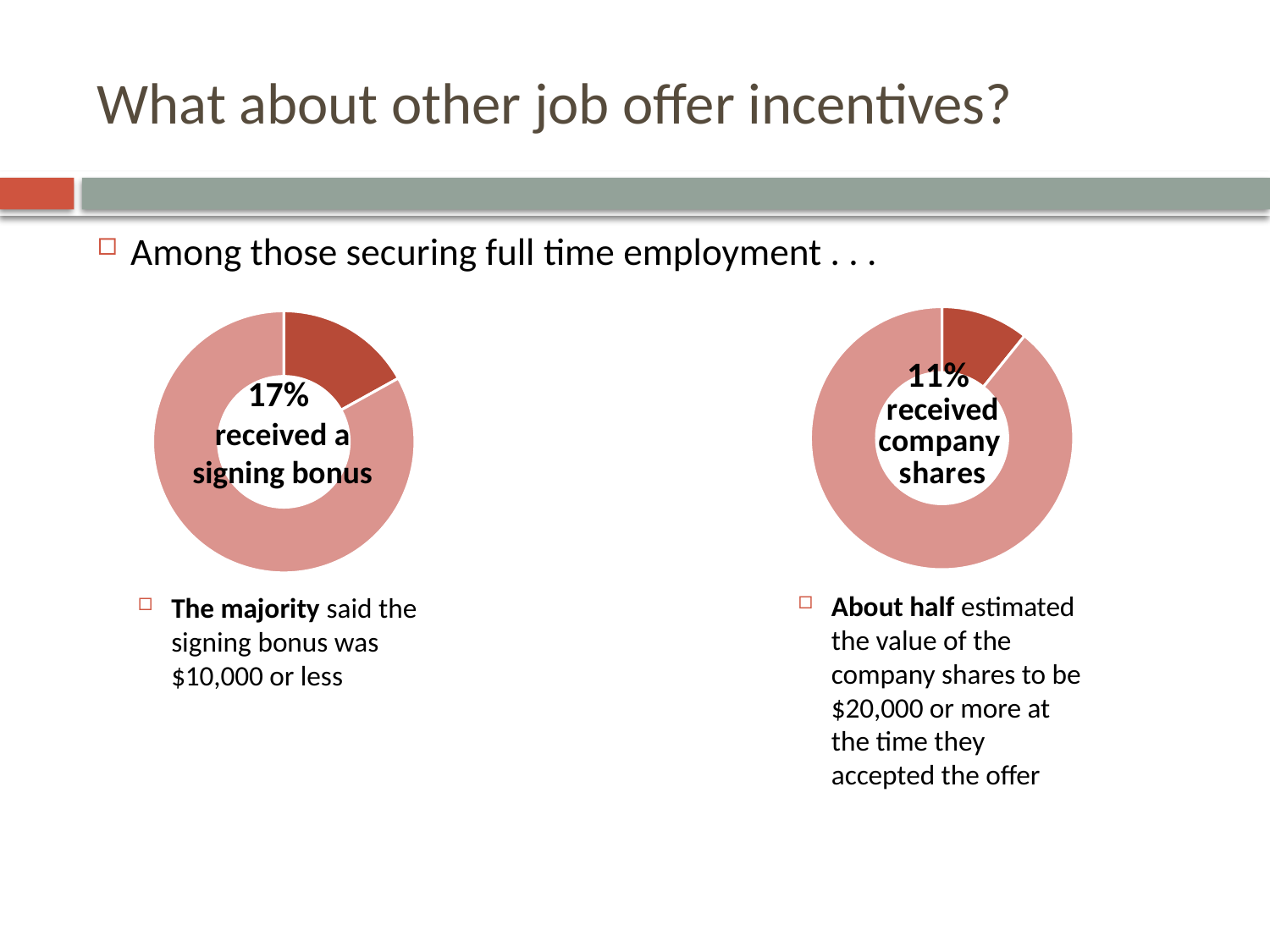
In the right chart, what share of the donut does the dark red slice represent? 11% In the left chart, what percentage received a signing bonus? 17% How many slices does the left donut chart have? 2 In the right chart, what percentage received company shares? 11% What text is printed in the centre of the left donut chart? 17% received a signing bonus How many slices does the right donut chart have? 2 Which is larger: the percentage who received a signing bonus (left chart) or the percentage who received company shares (right chart)? Signing bonus (17%) What kind of chart is the right chart showing the company shares percentage? Donut (pie) chart What kind of chart is the left chart showing the signing bonus share? Donut (pie) chart What is the difference in percentage points between the share who received a signing bonus (left chart) and the share who received company shares (right chart)? 6 percentage points In the left chart, is the dark red slice the larger or the smaller slice? Smaller How many charts are shown on the slide? 2